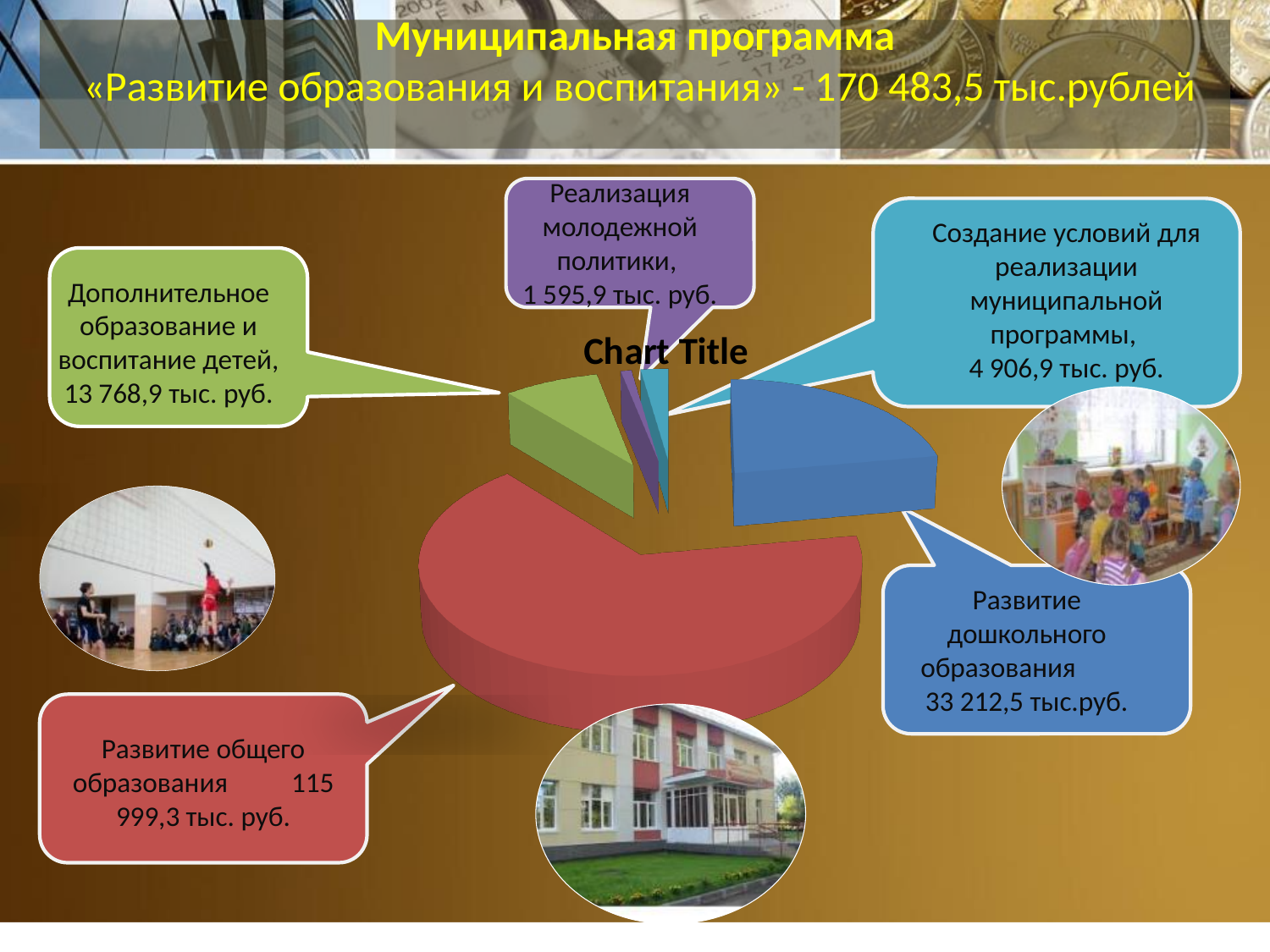
What is the value for «Развитие дошкольного образования»? 33 212,5 тыс.руб. What is the difference between «Развитие дошкольного образования» and «Дополнительное образование и воспитание детей»? 19 443,6 тыс. руб. Which slice of the pie chart is the smallest? Реализация молодежной политики What is the value for «Дополнительное образование и воспитание детей»? 13 768,9 тыс. руб. What is the title shown above the pie chart? Chart Title Which slice of the pie chart is the largest? Развитие общего образования How many slices does the pie chart have? 5 What is the value for «Развитие общего образования»? 115 999,3 тыс. руб. What is the value for «Реализация молодежной политики»? 1 595,9 тыс. руб. What is the value for «Создание условий для реализации муниципальной программы»? 4 906,9 тыс. руб. What kind of chart is shown on the slide? Pie chart Which is larger: «Развитие дошкольного образования» or «Дополнительное образование и воспитание детей»? Развитие дошкольного образования